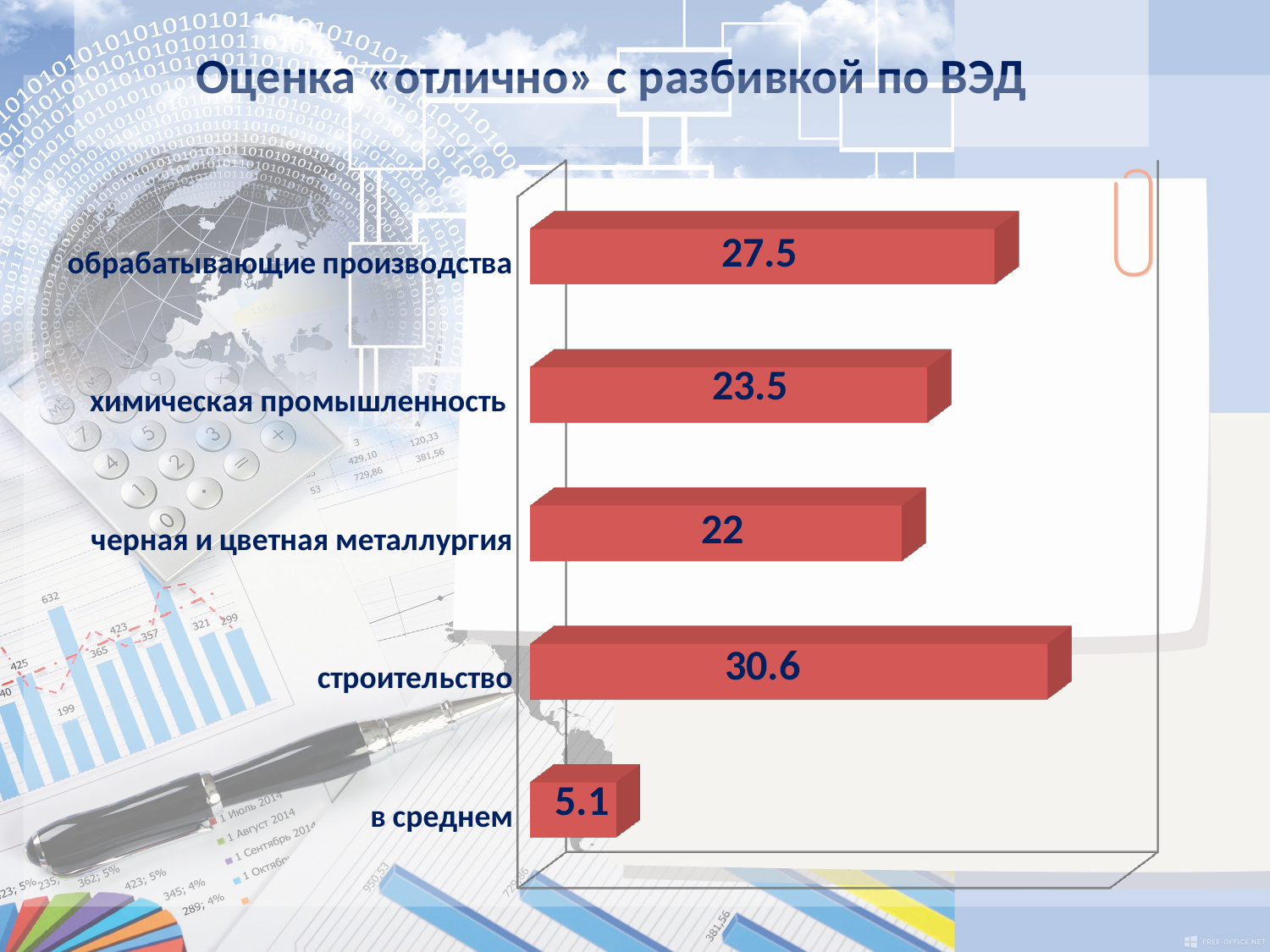
What is the value for химическая промышленность? 23.5 What is the value for в среднем? 5.1 What is the title of the slide? Оценка «отлично» с разбивкой по ВЭД What kind of chart is shown on the slide? bar chart Which is larger, the value for химическая промышленность or черная и цветная металлургия? химическая промышленность What is the value for обрабатывающие производства? 27.5 What is the value for черная и цветная металлургия? 22 What is the difference between the values for строительство and обрабатывающие производства? 3.1 What is the value for строительство? 30.6 Which category has the lowest value? в среднем Which category has the highest value? строительство How many categories are shown in the chart? 5